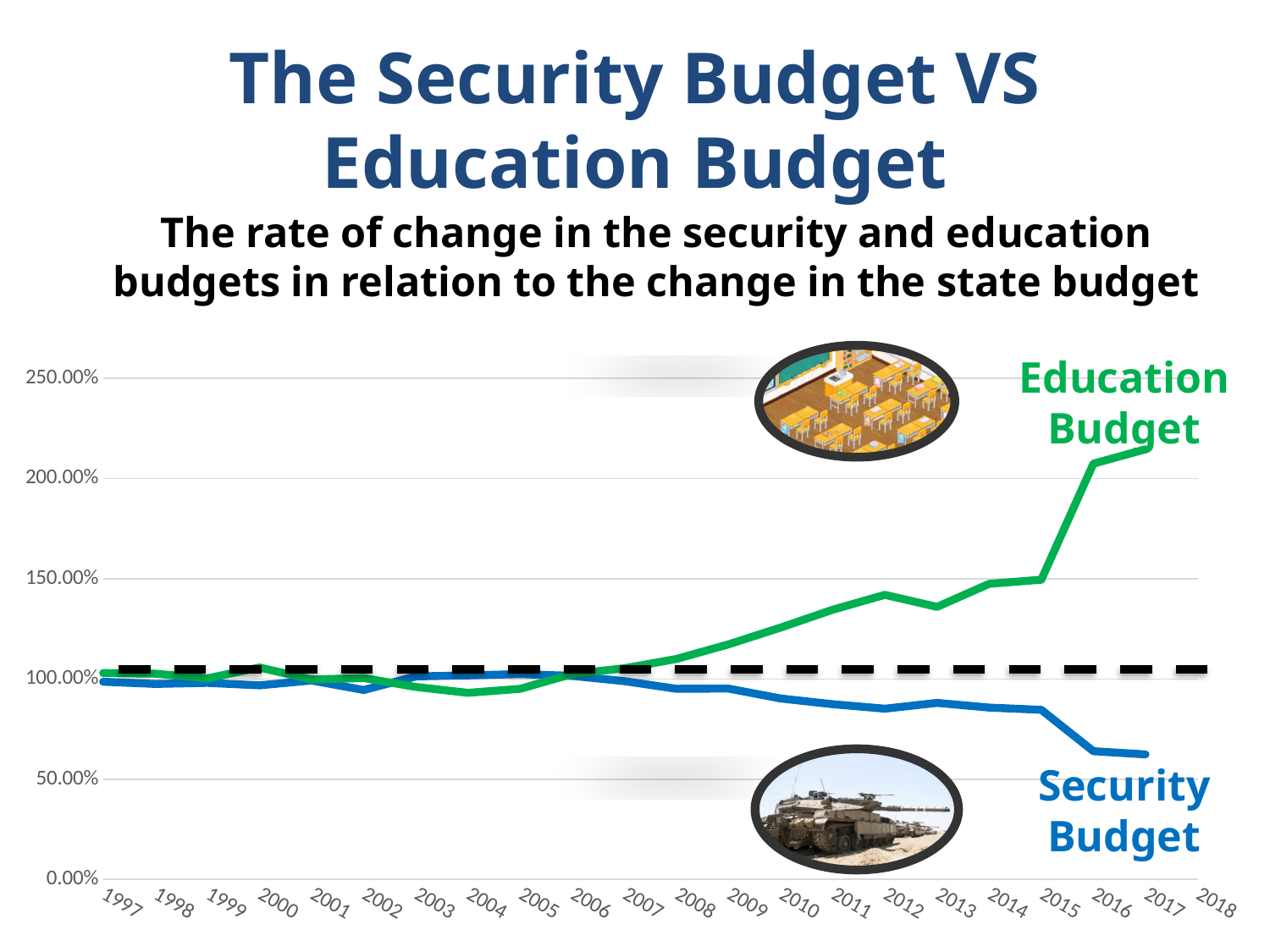
Is the Security Budget value for 2017 greater or less than 50.00%? greater Is the Security Budget value for 2017 greater or less than 100.00%? less Is the Education Budget value for 2012 greater or less than 100.00%? greater Does the Security Budget line generally rise or fall from 2006 to 2017? fall What is the first year shown on the x axis? 1997 How many data series (lines) are plotted on the chart? 2 Does the Education Budget line generally rise or fall from 2006 to 2017? rise In 2017, which series has the higher value, Education Budget or Security Budget? Education Budget What kind of chart is shown on the slide? line chart How many years are labelled along the x axis of the chart? 22 Which series reaches the highest value on the chart? Education Budget